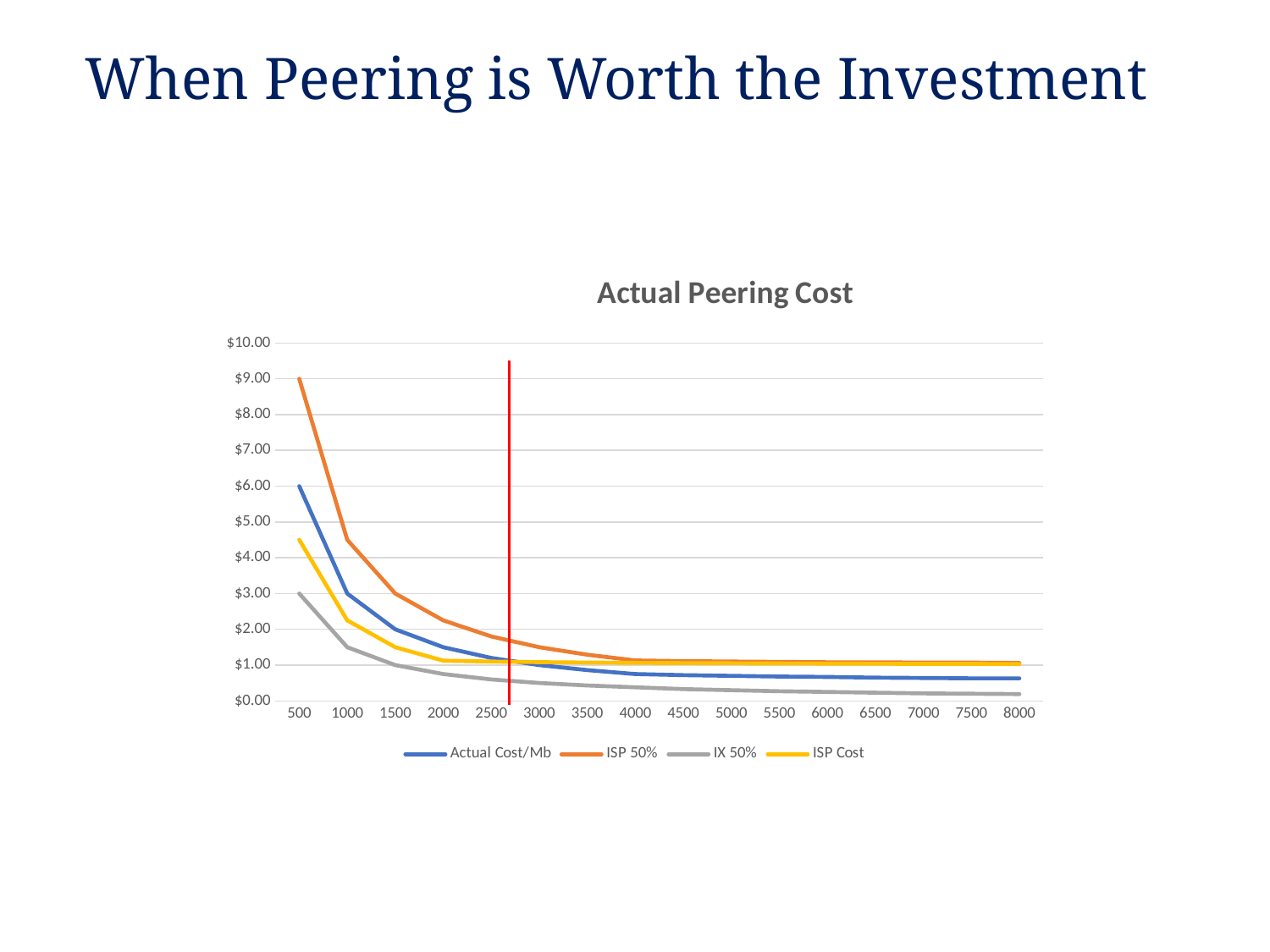
What is the value of Actual Cost/Mb at 500? $6.00 Do the values of the series rise or fall as the x axis increases from 500 to 8000? fall Is the value for ISP Cost at 500 greater or less than $4.00? greater What is the value of IX 50% at 500? $3.00 How many points are labelled along the x axis? 16 What is the title of the chart? Actual Peering Cost What is the value of Actual Cost/Mb at 1000? $3.00 What is the value of ISP 50% at 500? $9.00 How many series does the legend list? 4 What kind of chart is shown on the slide? line chart Which series has the lowest value at 8000? IX 50% Which series has the highest value at 500? ISP 50%